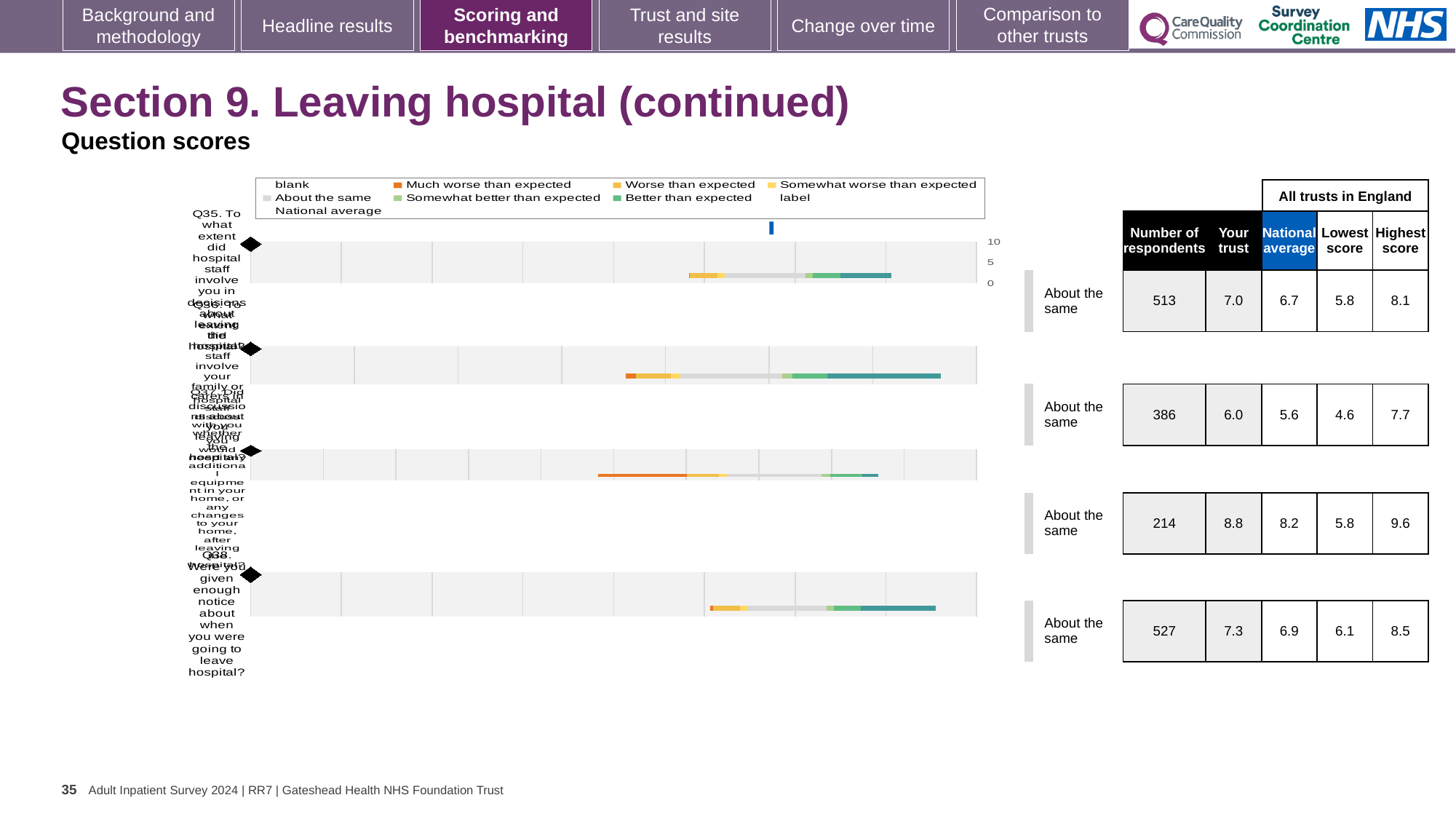
What is the difference between the 'Your trust' score and the national average for Q35, the first row? 0.3 Which row of the chart has the highest 'Your trust' score? the third row (8.8) In the chart legend, what colour represents 'Much worse than expected'? orange Which row of the chart has the lowest number of respondents? the third row (214) For the second row of the chart, is the 'Your trust' score (6.0) or the national average (5.6) larger? Your trust (6.0) What is the highest score among all trusts in England for the third row of the chart? 9.6 What is the 'Your trust' score for Q35 (the first row, about staff involving you in decisions about leaving hospital)? 7.0 What kind of chart is used to show the question scores on this slide? bar chart How many respondents answered Q38, the last row of the chart? 527 What is the national average for Q38 (the last row, about being given enough notice about leaving hospital)? 6.9 How many questions (rows) are plotted in the question scores chart? 4 What benchmark category is shown next to every row of the chart? About the same